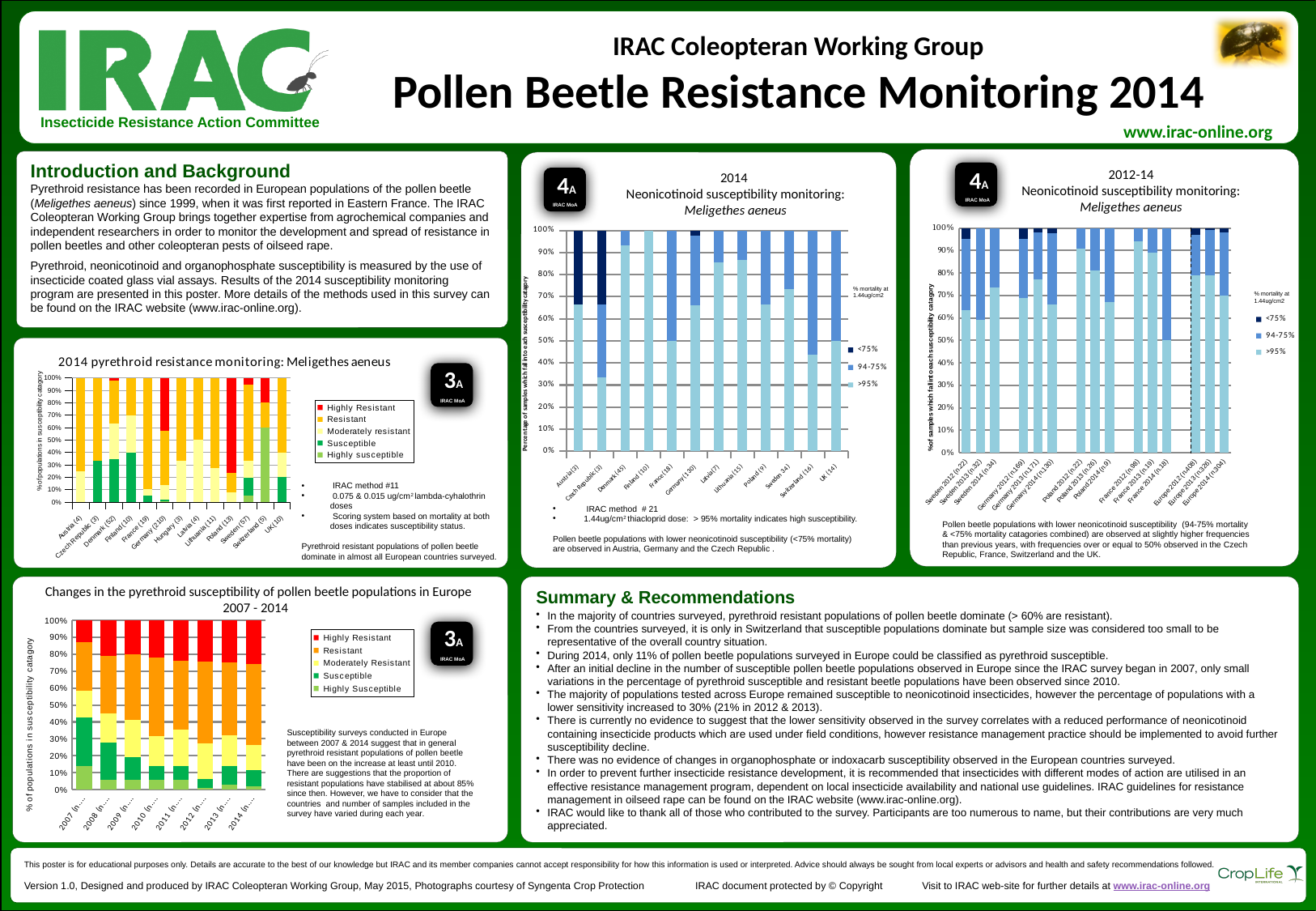
How many bars are shown in the '2012-14 Neonicotinoid susceptibility monitoring: Meligethes aeneus' chart? 15 How many countries are shown on the x axis of the '2014 pyrethroid resistance monitoring: Meligethes aeneus' chart? 13 How many series does the legend list in the '2014 Neonicotinoid susceptibility monitoring: Meligethes aeneus' chart? 3 What kind of chart is the '2014 pyrethroid resistance monitoring: Meligethes aeneus' chart? Stacked bar chart In the '2014 Neonicotinoid susceptibility monitoring' chart, is the '>95%' value for Finland (10) greater or less than 90%? greater How many series does the legend list in the '2014 pyrethroid resistance monitoring: Meligethes aeneus' chart? 5 In the 'Changes in the pyrethroid susceptibility of pollen beetle populations in Europe 2007 - 2014' chart, does the 'Susceptible' share rise or fall from 2007 to 2014? Fall In the '2012-14 Neonicotinoid susceptibility monitoring' chart, is the '>95%' value for Poland 2012 (n=22) greater or less than 80%? greater How many countries are shown on the x axis of the '2014 Neonicotinoid susceptibility monitoring: Meligethes aeneus' chart? 12 In the '2014 pyrethroid resistance monitoring' chart, which colour represents 'Highly Resistant' in the legend? Red In the '2014 Neonicotinoid susceptibility monitoring' chart, is the '>95%' value for Czech Republic (3) greater or less than 50%? less